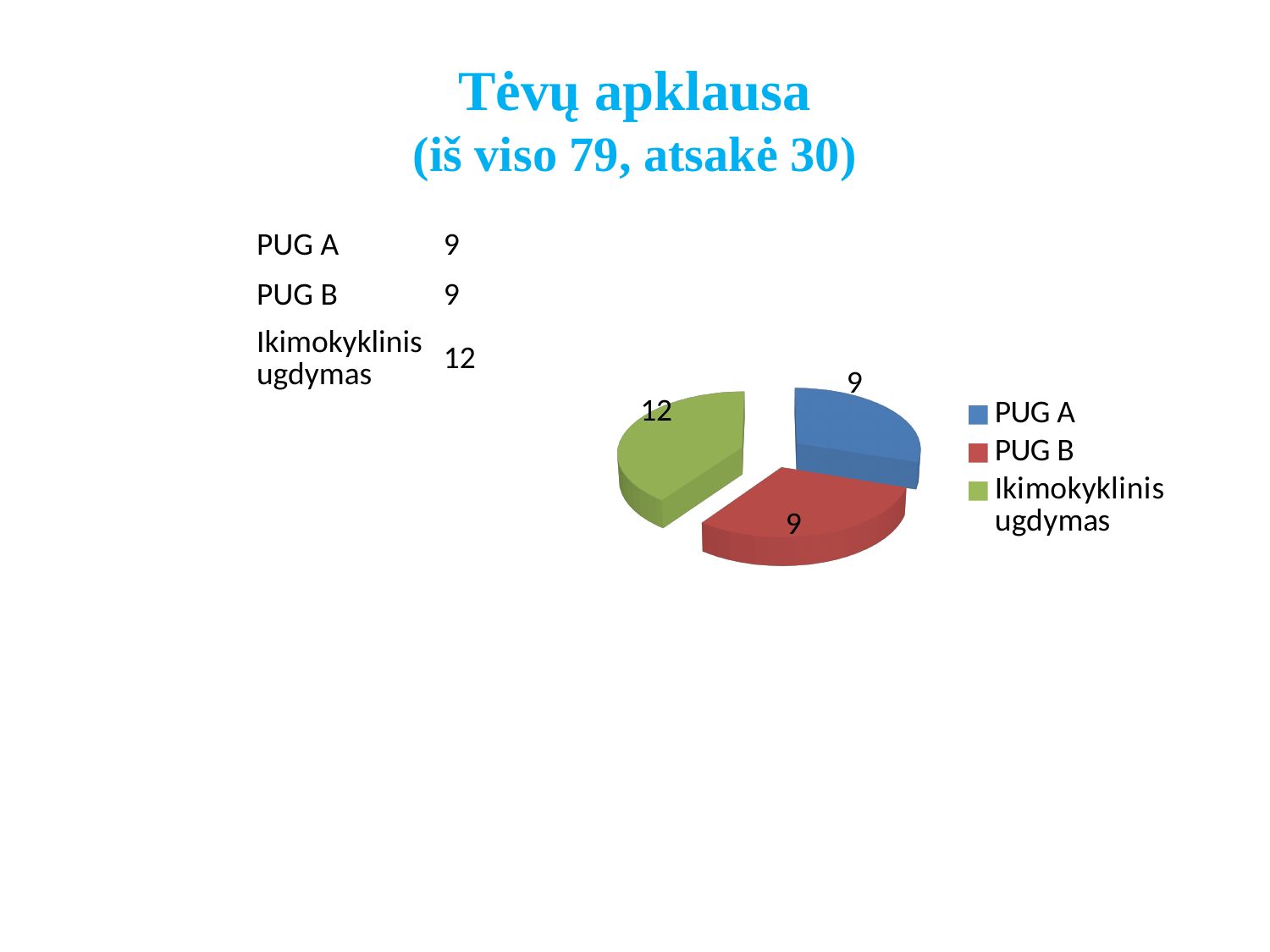
What is the value for Ikimokyklinis ugdymas? 12 How many slices does the pie chart have? 3 What share of the pie does Ikimokyklinis ugdymas represent? 40% What is the difference between the value for Ikimokyklinis ugdymas and the value for PUG A? 3 Which is larger, the value for Ikimokyklinis ugdymas or the value for PUG B? Ikimokyklinis ugdymas Which category has the largest slice? Ikimokyklinis ugdymas What kind of chart is shown on the slide? pie chart What is the value for PUG A? 9 How many entries does the legend list? 3 What is the total of all slices in the pie chart? 30 What is the value for PUG B? 9 What colour is the slice for PUG B? red